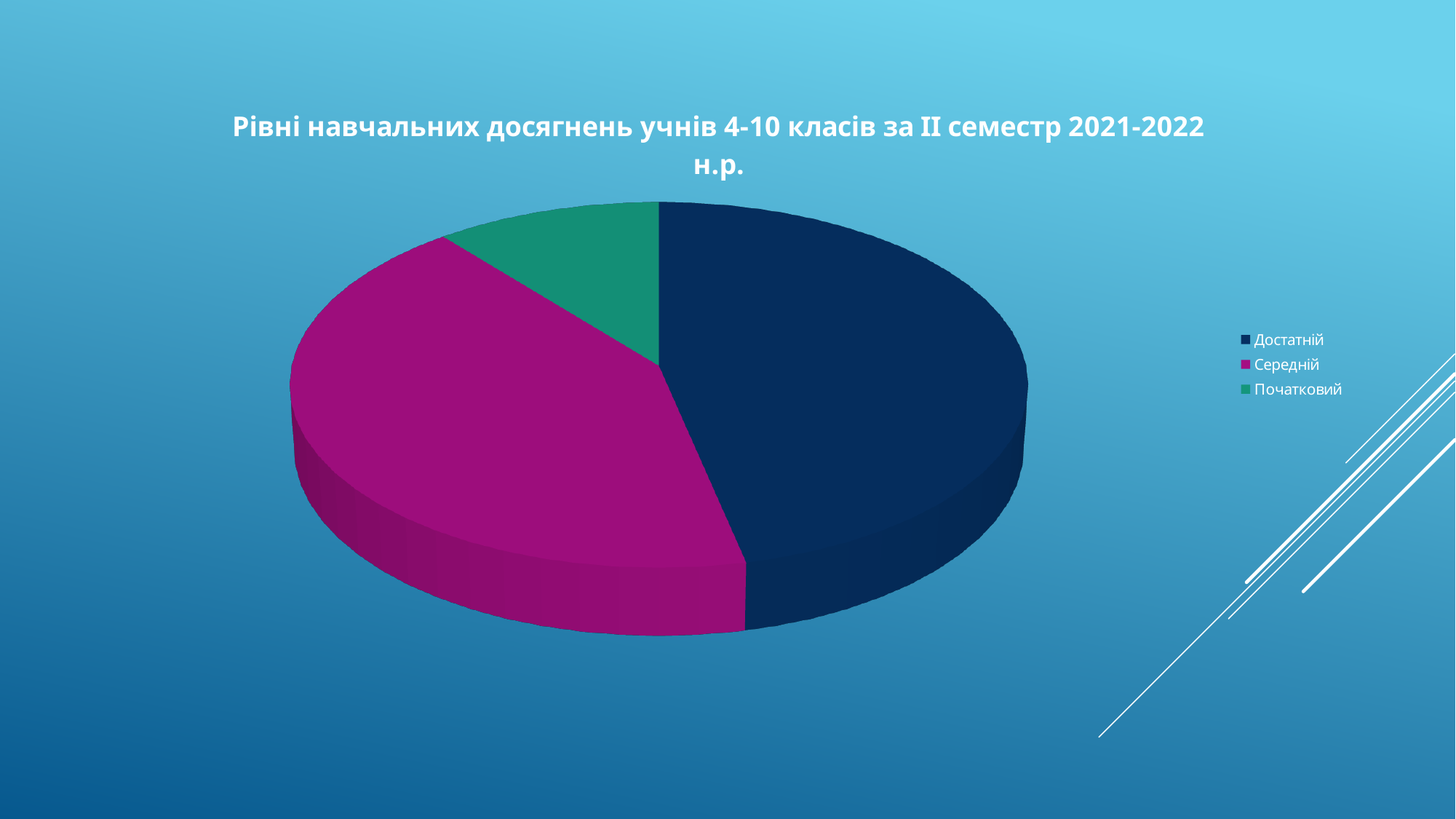
How many entries does the legend list? 3 How many slices does the pie chart have? 3 Which slice is larger, Середній or Початковий? Середній Which category has the smallest slice of the pie? Початковий Which category is shown in green in the pie chart? Початковий Which slice is larger, Достатній or Початковий? Достатній What kind of chart is shown on the slide? Pie chart What is the title of the chart? Рівні навчальних досягнень учнів 4-10 класів за ІІ семестр 2021-2022 н.р.